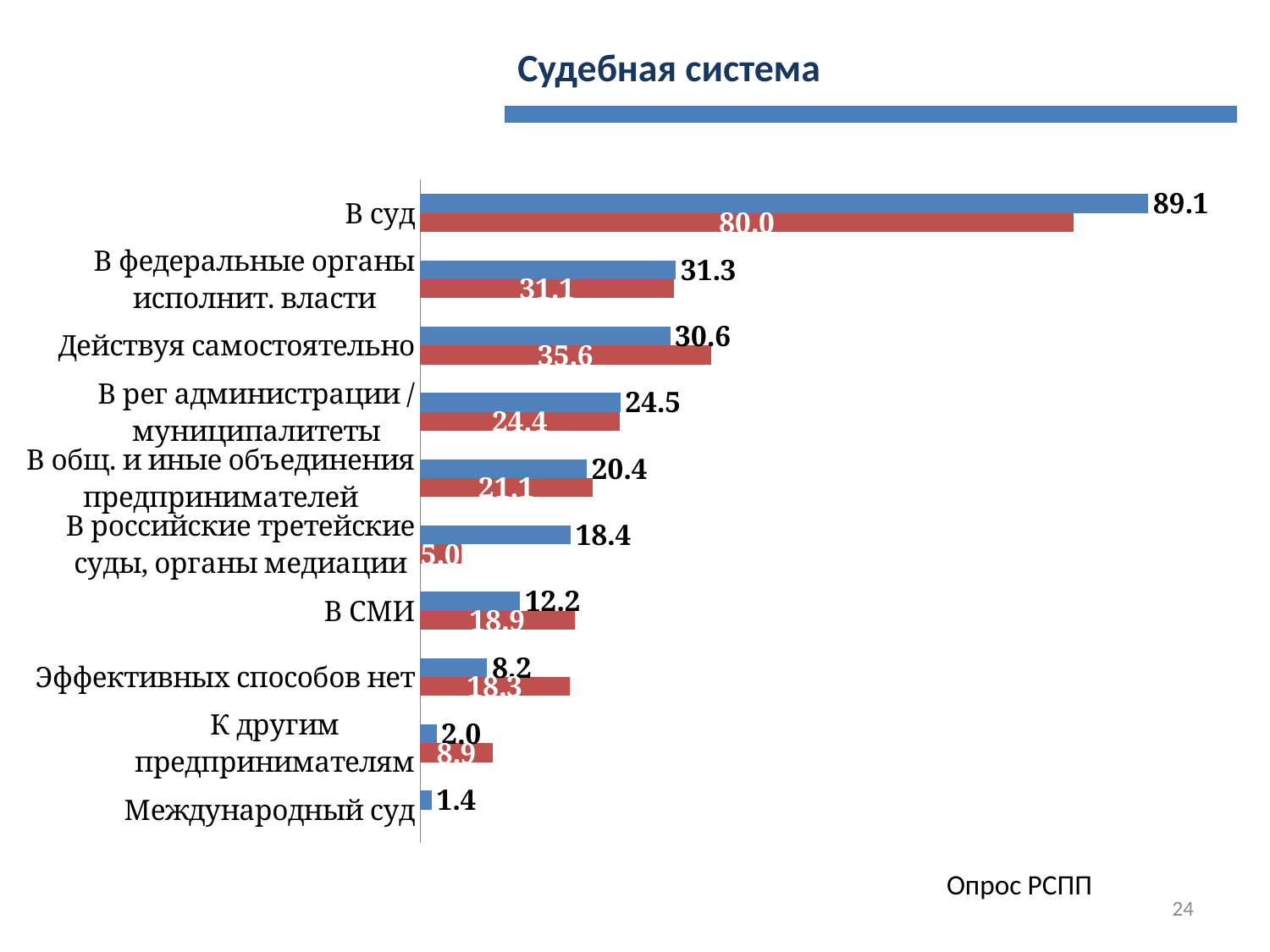
For "Действуя самостоятельно", which bar is larger, the blue or the red? red What is the value of the red bar for "Эффективных способов нет"? 18.3 How many categories are shown on the chart? 10 Which category has the highest blue bar value? В суд What is the difference between the blue and red bar values for "В суд"? 9.1 What is the value of the blue bar for "В СМИ"? 12.2 What is the value of the red bar for "В суд"? 80.0 What is the title of the slide? Судебная система What is the value of the red bar for "Действуя самостоятельно"? 35.6 What is the value of the blue bar for "В суд"? 89.1 What type of chart is shown on the slide? bar chart Which category has the lowest blue bar value? Международный суд